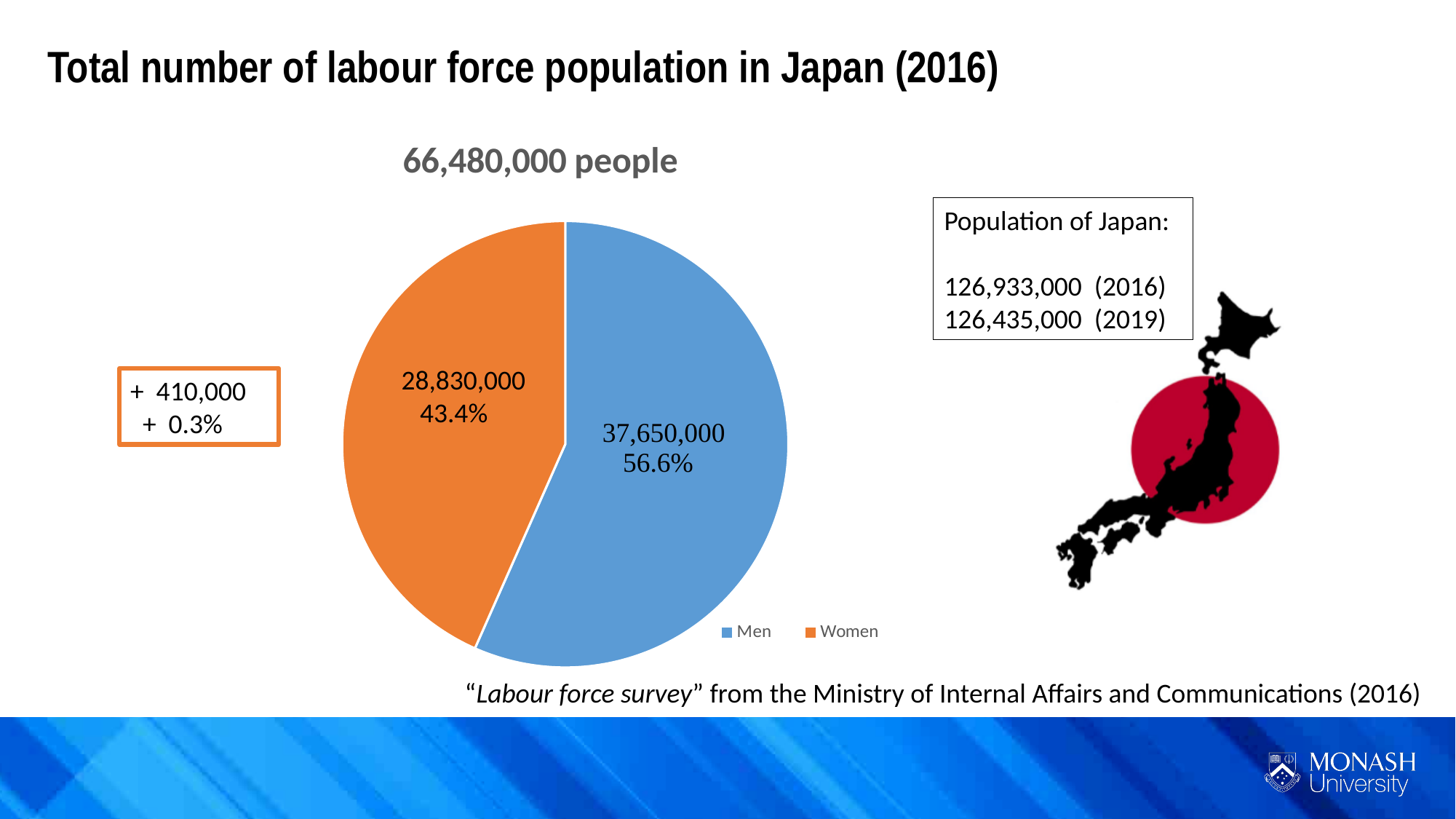
What colour is the Women slice in the pie chart? orange What is the value for Women in the pie chart? 28,830,000 What share of the pie does the Men slice represent? 56.6% Which category has the smallest slice in the pie chart? Women Which is larger, the value for Men or the value for Women? Men What kind of chart is shown on the slide? pie chart Which category has the largest slice in the pie chart? Men What is the chart title shown above the pie chart? 66,480,000 people What is the difference between the value for Men and the value for Women? 8,820,000 How many categories does the pie chart have? 2 What share of the pie does the Women slice represent? 43.4% What is the value for Men in the pie chart? 37,650,000